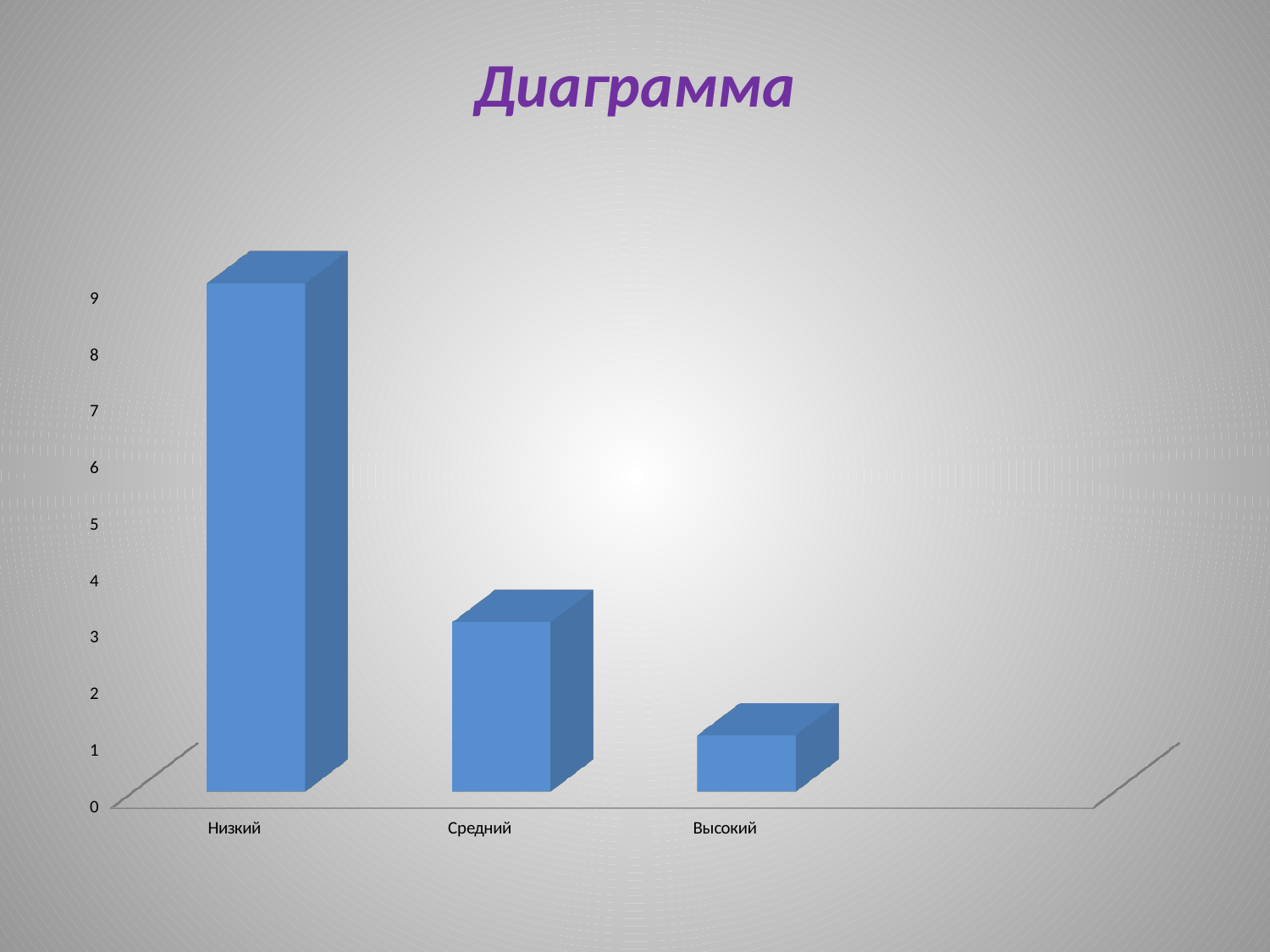
Is the value for Высокий greater or less than 2? less Is the value for Средний greater or less than 2? greater Is the value for Низкий greater or less than 8? greater Which is larger, the value for Средний or the value for Высокий? Средний How many categories are shown on the x axis of the chart? 3 Do the bar values rise or fall from left to right along the x axis? Fall What is the title of the slide above the chart? Диаграмма Which is larger, the value for Низкий or the value for Средний? Низкий What kind of chart is shown on the slide? Bar chart Which category has the highest bar? Низкий Which category has the lowest bar? Высокий